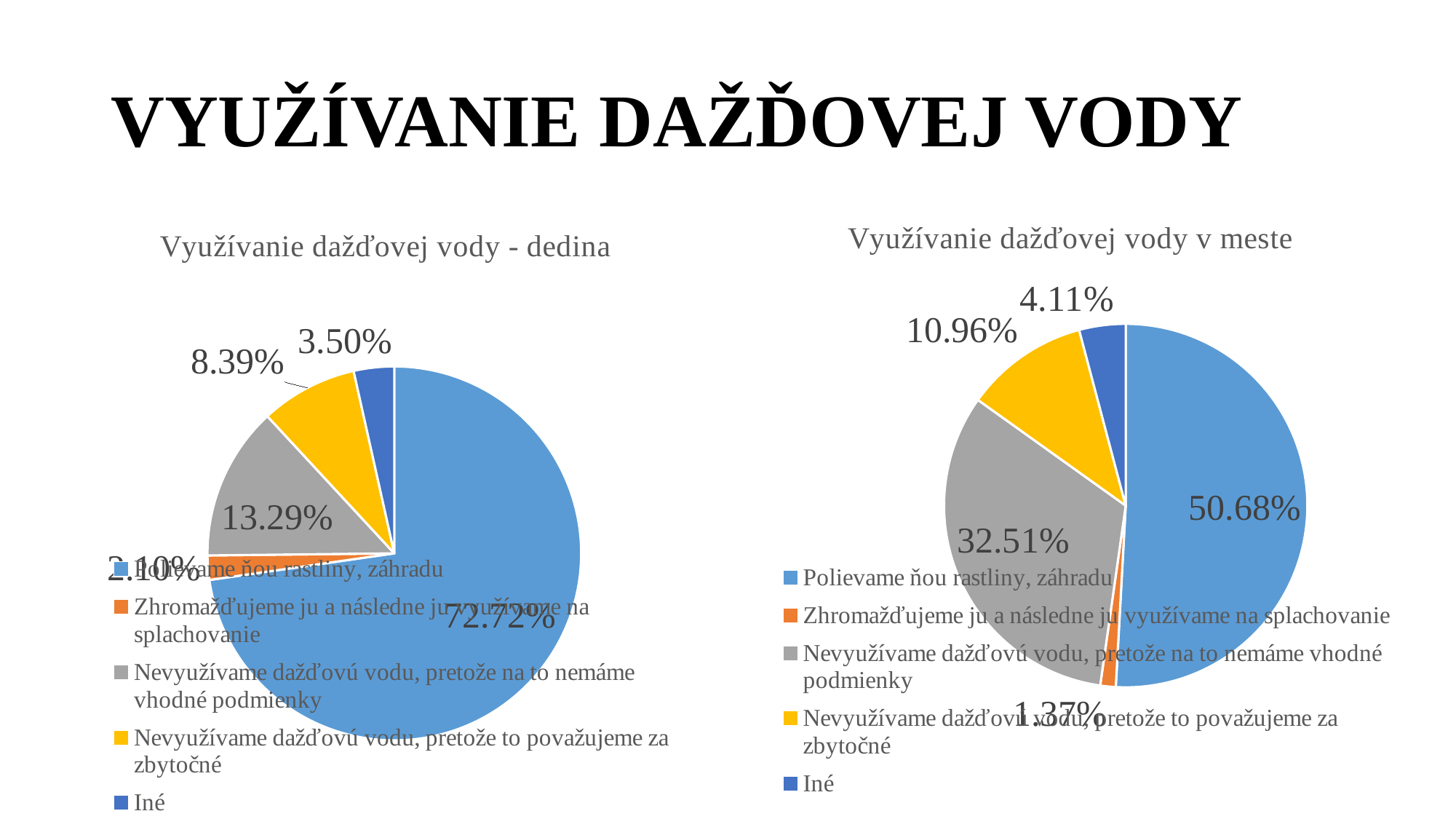
In the chart "Využívanie dažďovej vody - dedina", what percentage is shown for "Iné"? 3.50% In the chart "Využívanie dažďovej vody v meste", what percentage is shown for "Nevyužívame dažďovú vodu, pretože na to nemáme vhodné podmienky"? 32.51% In the chart "Využívanie dažďovej vody v meste", which category has the smallest slice? Zhromažďujeme ju a následne ju využívame na splachovanie In the chart "Využívanie dažďovej vody - dedina", what percentage is shown for "Nevyužívame dažďovú vodu, pretože na to nemáme vhodné podmienky"? 13.29% In the chart "Využívanie dažďovej vody v meste", what percentage is shown for "Polievame ňou rastliny, záhradu"? 50.68% How many categories does the legend of the chart "Využívanie dažďovej vody v meste" list? 5 What is the difference between the "Iné" share in the chart "Využívanie dažďovej vody v meste" (4.11%) and in the chart "Využívanie dažďovej vody - dedina" (3.50%)? 0.61% Which is larger: the "Nevyužívame dažďovú vodu, pretože to považujeme za zbytočné" share in the chart "Využívanie dažďovej vody - dedina" or in the chart "Využívanie dažďovej vody v meste"? Využívanie dažďovej vody v meste In the chart "Využívanie dažďovej vody v meste", what percentage is shown for "Zhromažďujeme ju a následne ju využívame na splachovanie"? 1.37% In the chart "Využívanie dažďovej vody - dedina", which category has the largest slice? Polievame ňou rastliny, záhradu What type of chart is used for "Využívanie dažďovej vody - dedina"? pie chart In the chart "Využívanie dažďovej vody - dedina", what percentage is shown for "Polievame ňou rastliny, záhradu"? 72.72%